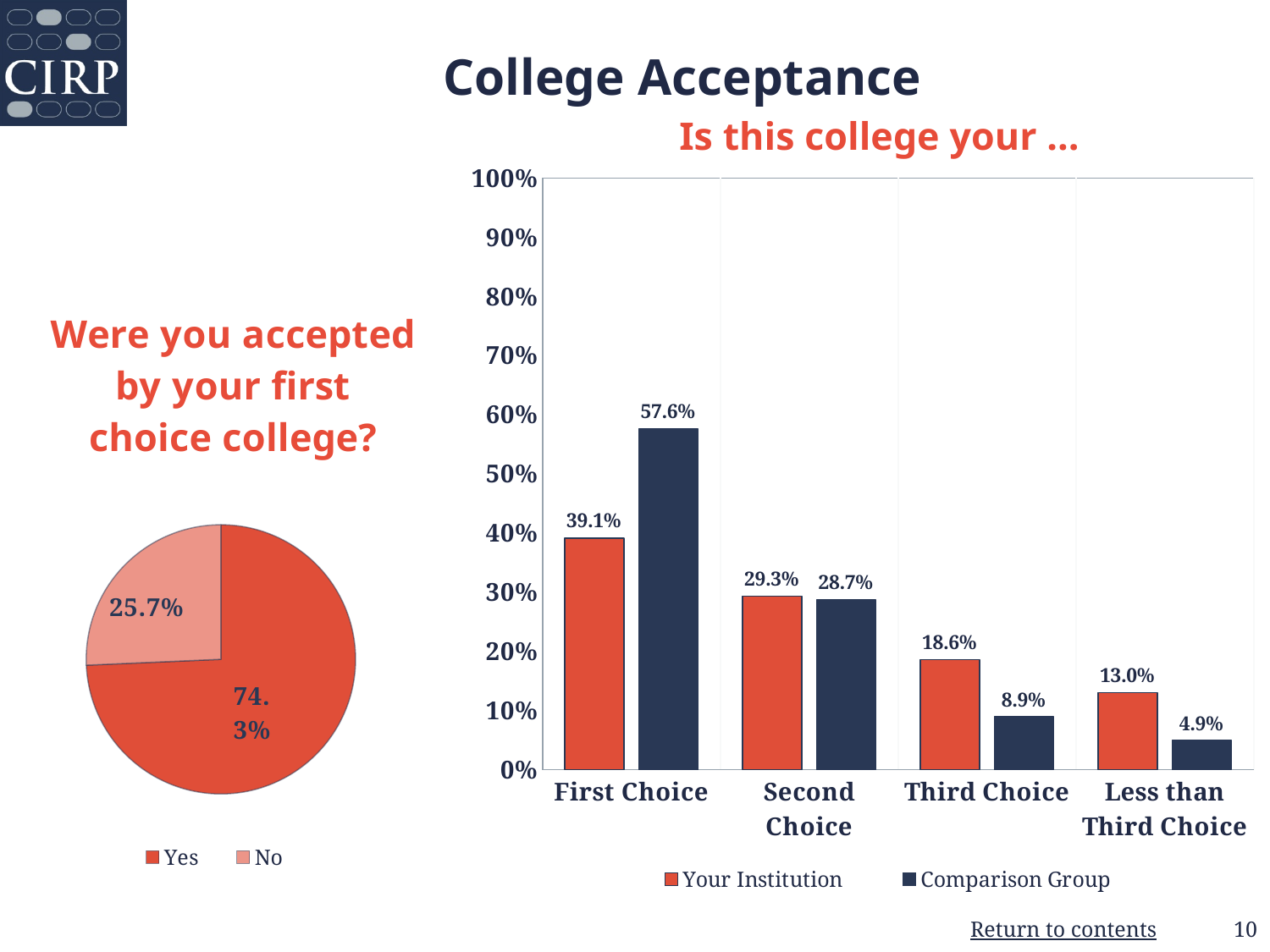
In the 'Is this college your ...' bar chart, which category has the lowest Your Institution value? Less than Third Choice In the 'Is this college your ...' bar chart, which is larger for Third Choice: Your Institution or Comparison Group? Your Institution In the 'Were you accepted by your first choice college?' pie chart, what is the value for No? 25.7% In the 'Is this college your ...' bar chart, what is the difference between the Comparison Group and Your Institution values for First Choice? 18.5% In the 'Is this college your ...' bar chart, do the Comparison Group values rise or fall from First Choice to Less than Third Choice? fall What kind of chart is shown on the left of the slide? pie chart In the 'Is this college your ...' bar chart, how many categories are shown on the x axis? 4 In the 'Is this college your ...' bar chart, what is the value for Comparison Group for Less than Third Choice? 4.9% In the 'Were you accepted by your first choice college?' pie chart, what share of the pie is Yes? 74.3% In the 'Is this college your ...' bar chart, what is the value for Your Institution for First Choice? 39.1% In the 'Is this college your ...' bar chart, how many series does the legend list? 2 In the 'Is this college your ...' bar chart, which category has the highest Comparison Group value? First Choice